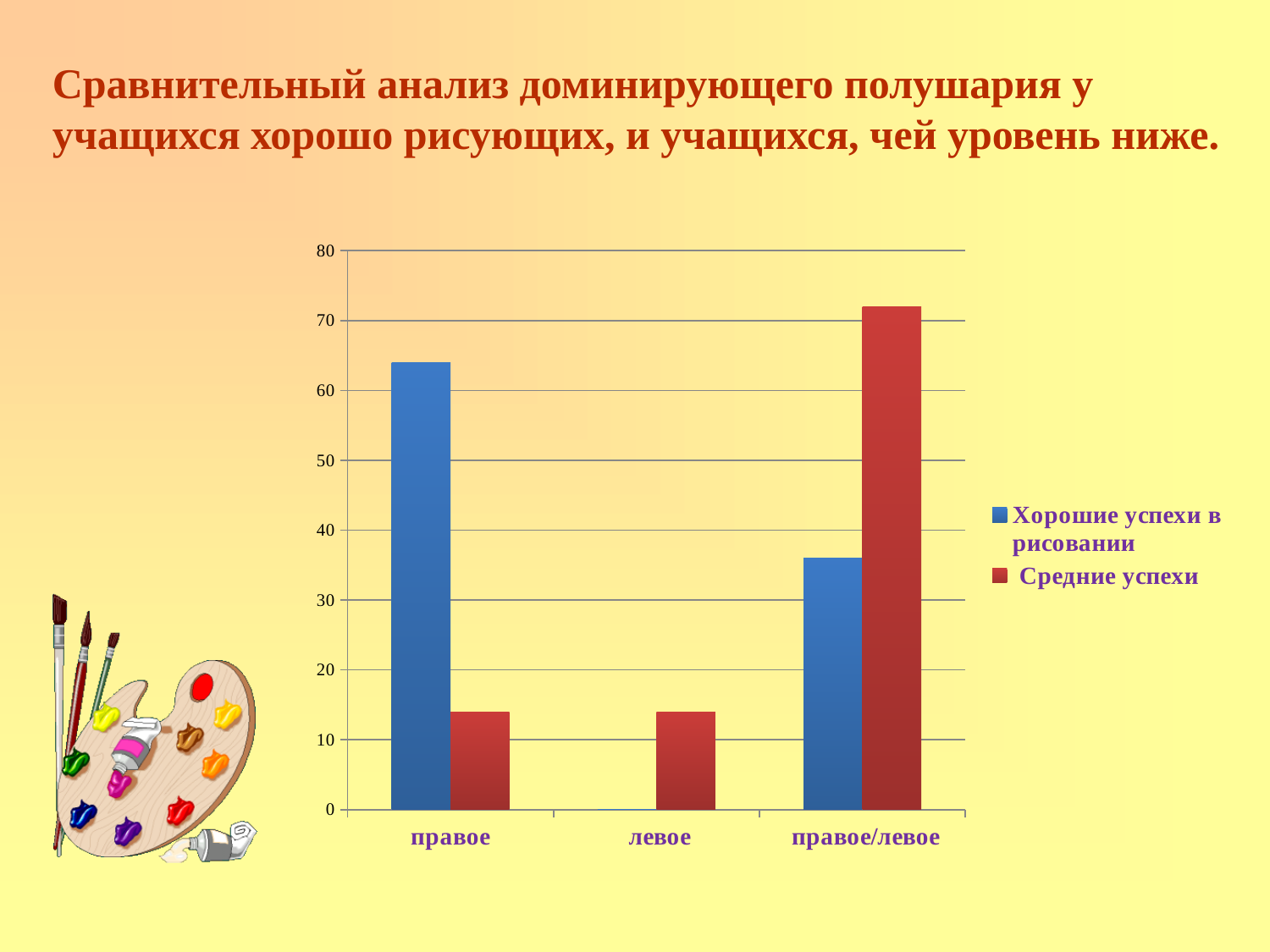
For the category "правое", which series has the larger value: "Хорошие успехи в рисовании" or "Средние успехи"? Хорошие успехи в рисовании How many series does the chart's legend list? 2 Which category has the highest value for the series "Хорошие успехи в рисовании"? правое What kind of chart is shown on the slide? bar chart Is the value for "правое" in the series "Средние успехи" greater or less than 20? less Is the value for "правое/левое" in the series "Средние успехи" greater or less than 70? greater Is the value for "правое" in the series "Хорошие успехи в рисовании" greater or less than 60? greater For the category "правое/левое", which series has the larger value: "Хорошие успехи в рисовании" or "Средние успехи"? Средние успехи What colour represents the series "Средние успехи" in the chart? red Which category has the lowest value for the series "Хорошие успехи в рисовании"? левое How many categories are shown on the x axis of the chart? 3 Which category has the highest value for the series "Средние успехи"? правое/левое